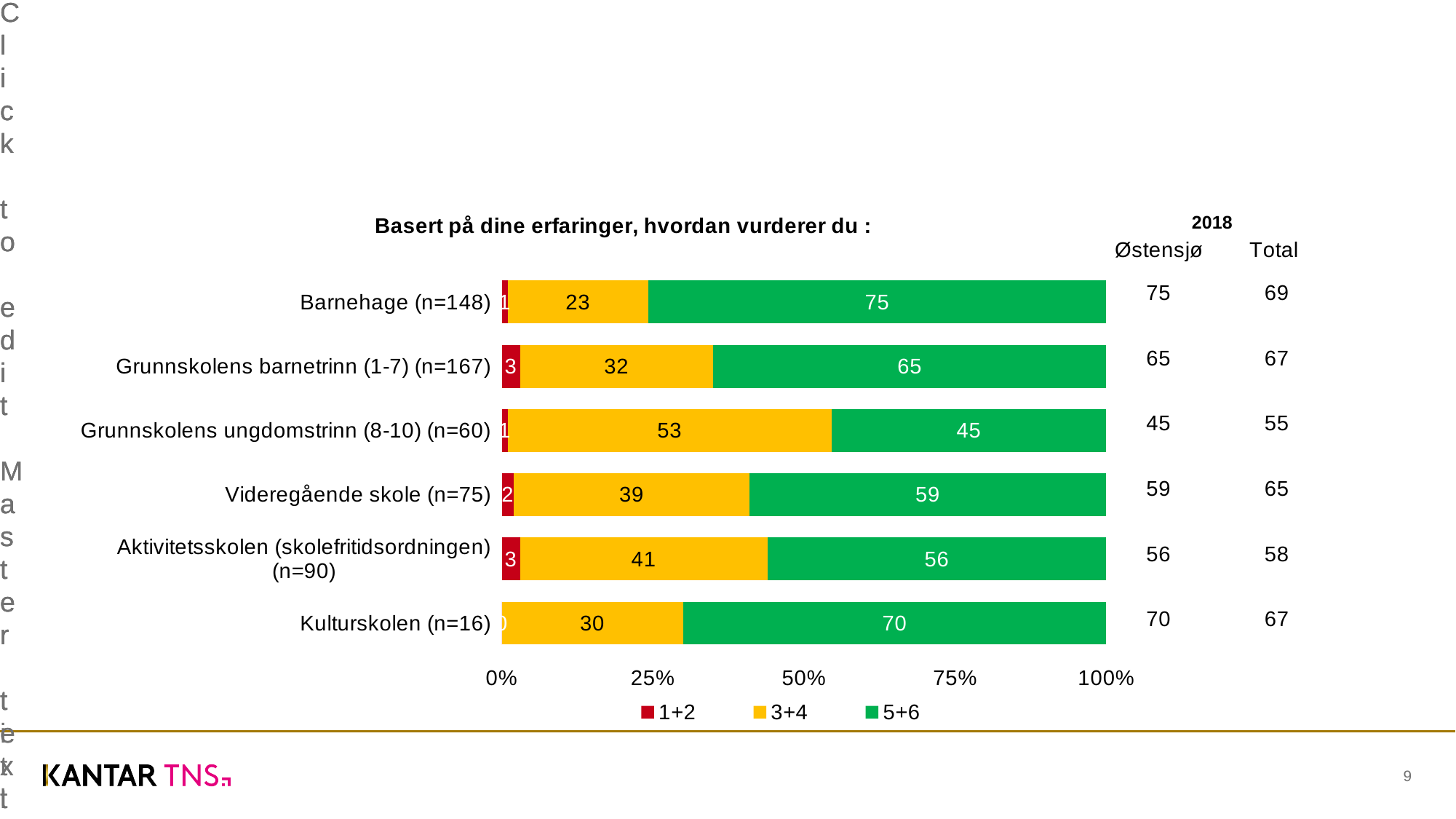
What is the difference between the 5+6 values for Barnehage (n=148) and Kulturskolen (n=16)? 5 What is the 1+2 value for Aktivitetsskolen (skolefritidsordningen) (n=90)? 3 Which category has the highest 3+4 value? Grunnskolens ungdomstrinn (8-10) (n=60) How many series does the legend list? 3 Which is larger: the 3+4 value for Videregående skole (n=75) or the 3+4 value for Grunnskolens barnetrinn (1-7) (n=167)? Videregående skole (n=75) What is the 5+6 value for Barnehage (n=148)? 75 What kind of chart is shown on the slide? Stacked bar chart How many categories are shown in the chart? 6 Which category has the lowest 5+6 value? Grunnskolens ungdomstrinn (8-10) (n=60) What is the title of the chart? Basert på dine erfaringer, hvordan vurderer du : What is the 3+4 value for Grunnskolens ungdomstrinn (8-10) (n=60)? 53 Which category has the highest 5+6 value? Barnehage (n=148)